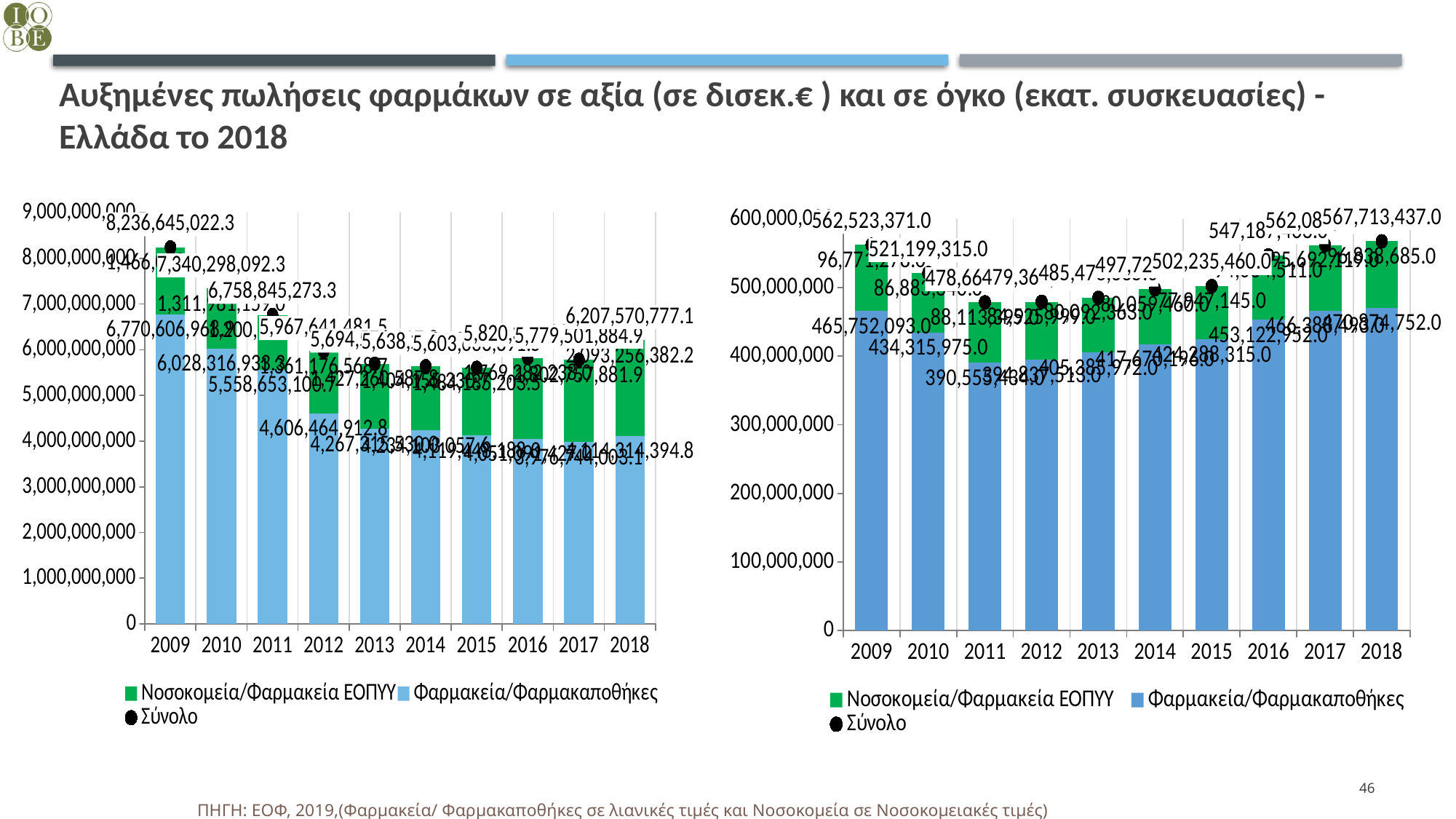
In the right chart (sales in volume), is the Φαρμακεία/Φαρμακαποθήκες value for 2011 greater or less than 400,000,000? less In the left chart (sales in value), what is the Φαρμακεία/Φαρμακαποθήκες value for 2018? 4,114,314,394.8 In the right chart (sales in volume), what is the Σύνολο value for 2009? 562,523,371.0 How many series does the legend of the right chart list? 3 In the left chart (sales in value), what is the difference between the Σύνολο for 2009 and the Σύνολο for 2018? 2,029,074,245.2 In the left chart (sales in value), which year has the highest Σύνολο? 2009 In the right chart (sales in volume), what is the Φαρμακεία/Φαρμακαποθήκες value for 2010? 434,315,975.0 In the right chart (sales in volume), which is larger: the Σύνολο for 2009 or the Σύνολο for 2018? 2018 In the left chart (sales in value), what is the Σύνολο value for 2009? 8,236,645,022.3 How many years are shown on the x axis of the left chart? 10 In the left chart (sales in value), what is the Σύνολο value for 2018? 6,207,570,777.1 What kind of chart is the left chart on the slide? bar chart